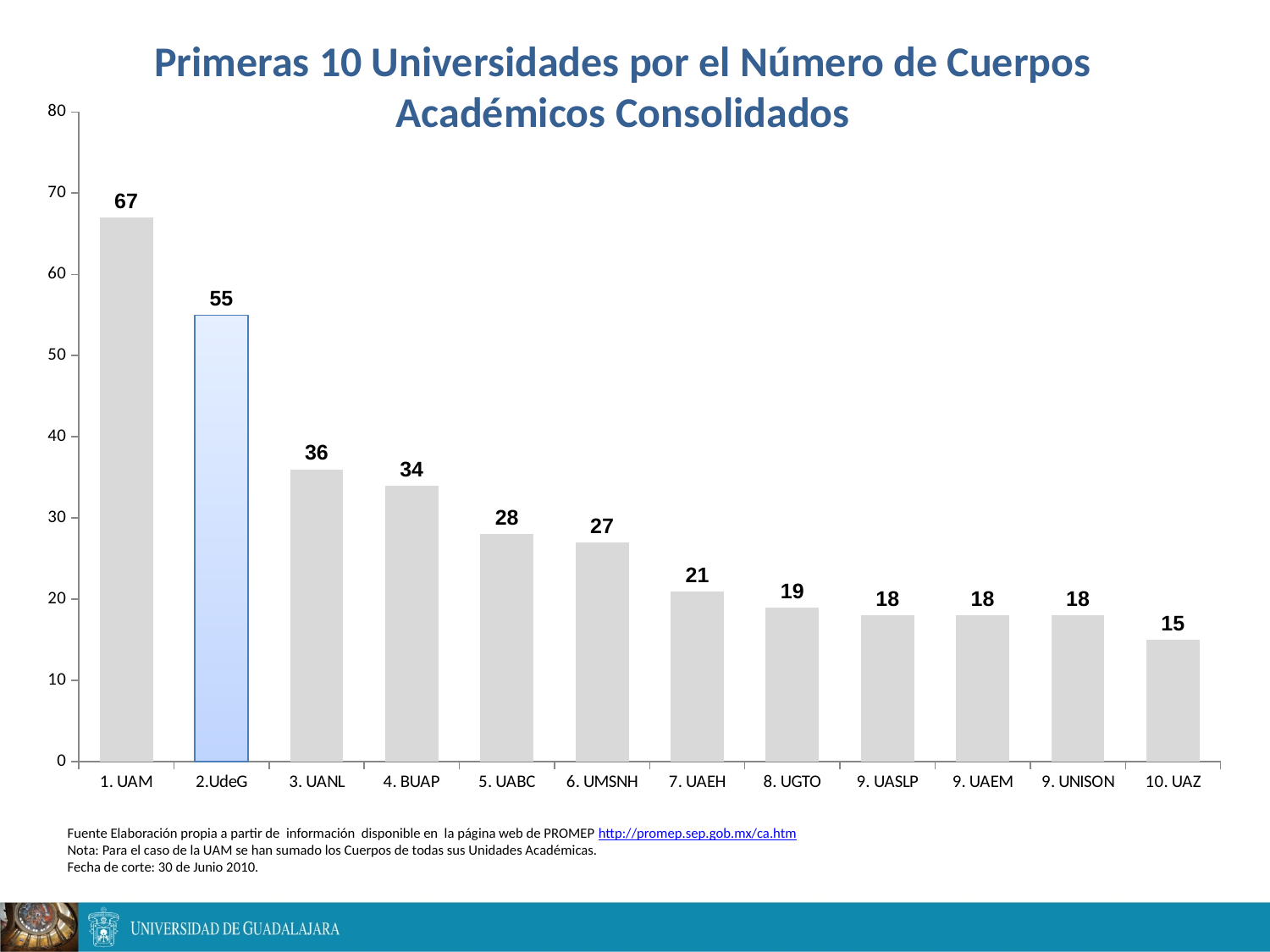
What is the value for 1. UAM? 67 Which category has the highest value? 1. UAM Which category has the lowest value? 10. UAZ Is the value for 7. UAEH greater or less than 30? less What kind of chart is shown on the slide? bar chart Which is larger, the value for 3. UANL or the value for 4. BUAP? 3. UANL What is the value for 2.UdeG? 55 What is the value for 10. UAZ? 15 What is the value for 5. UABC? 28 Do the values rise or fall from left to right along the x axis? fall What is the difference between the values for 1. UAM and 2.UdeG? 12 How many categories are shown on the x axis? 12